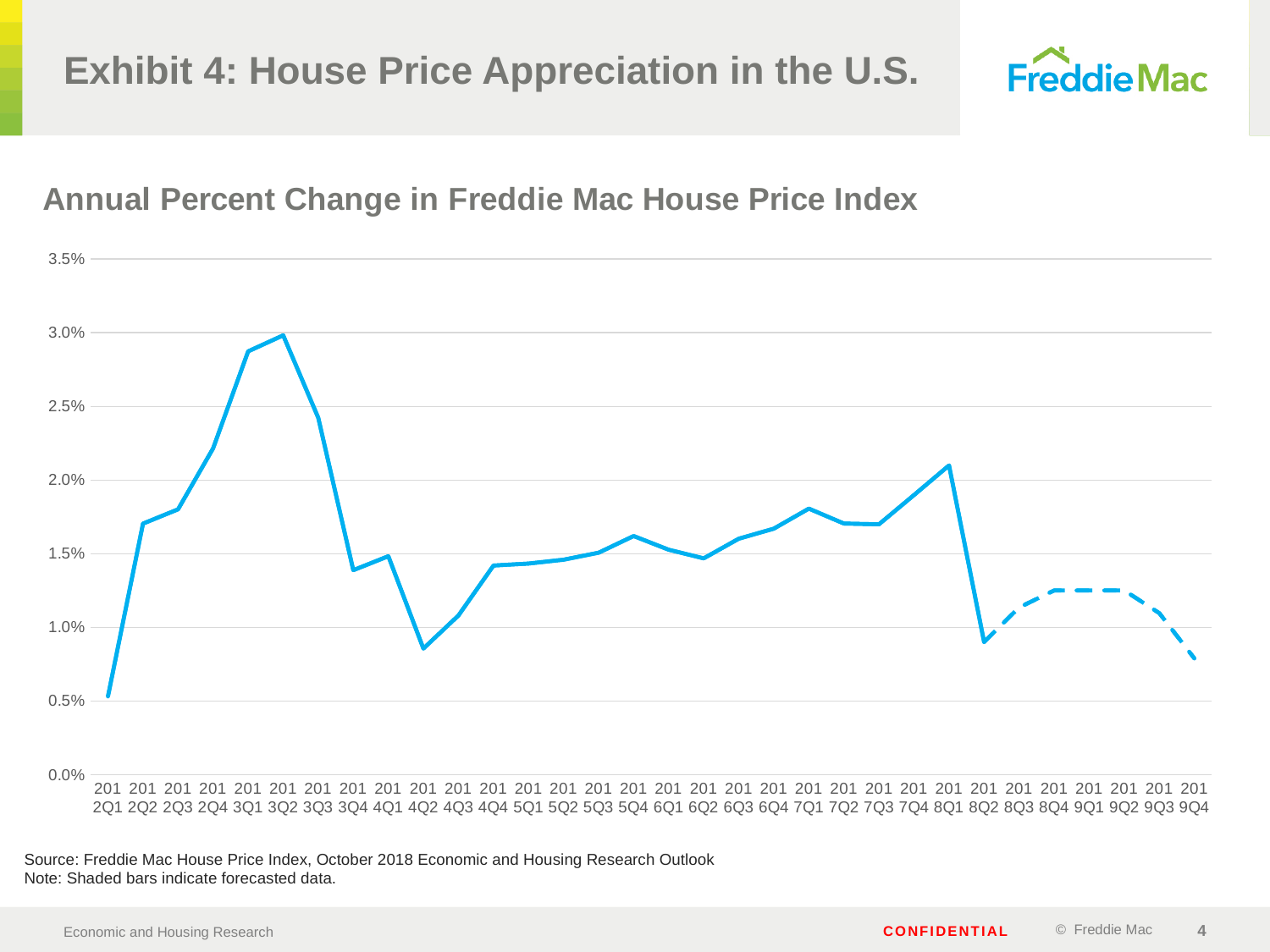
Which quarter has the lowest annual percent change in the chart? 2012Q1 Which is larger, the value for 2013Q1 or the value for 2013Q3? 2013Q1 What kind of chart is shown on the slide? line chart Do the values rise or fall from 2013Q2 to 2014Q2? fall Is the value for 2019Q4 greater or less than 1.0%? less Is the value for 2013Q2 greater or less than 2.5%? greater Which quarter has the highest annual percent change in the chart? 2013Q2 Which is larger, the value for 2012Q1 or the value for 2019Q4? 2019Q4 Is the value for 2014Q2 greater or less than 1.0%? less What is the title of the chart? Annual Percent Change in Freddie Mac House Price Index How many quarterly data points are plotted on the chart? 32